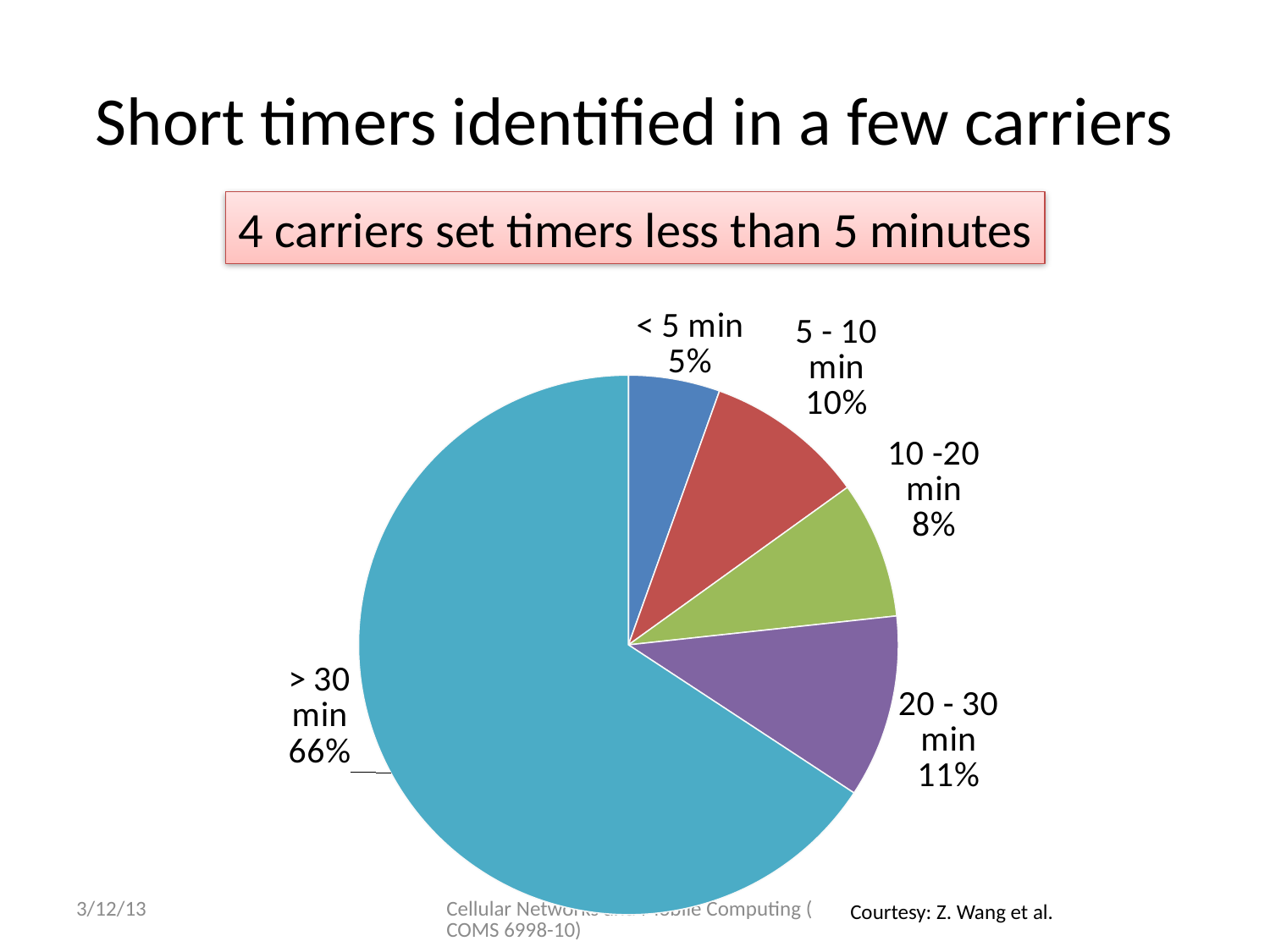
What is the difference in percentage points between the "> 30 min" slice and the "20 - 30 min" slice? 55 What share of the pie does the "> 30 min" slice represent? 66% What percentage is shown for the "20 - 30 min" slice? 11% Which is larger, the "20 - 30 min" slice or the "10 -20 min" slice? 20 - 30 min What percentage is shown for the "5 - 10 min" slice? 10% How many slices does the pie chart have? 5 Which slice of the pie is the smallest? < 5 min What colour is the "> 30 min" slice? Teal (light blue) Which slice of the pie is the largest? > 30 min What kind of chart is shown on the slide? Pie chart What percentage is shown for the "< 5 min" slice? 5% What percentage is shown for the "10 -20 min" slice? 8%